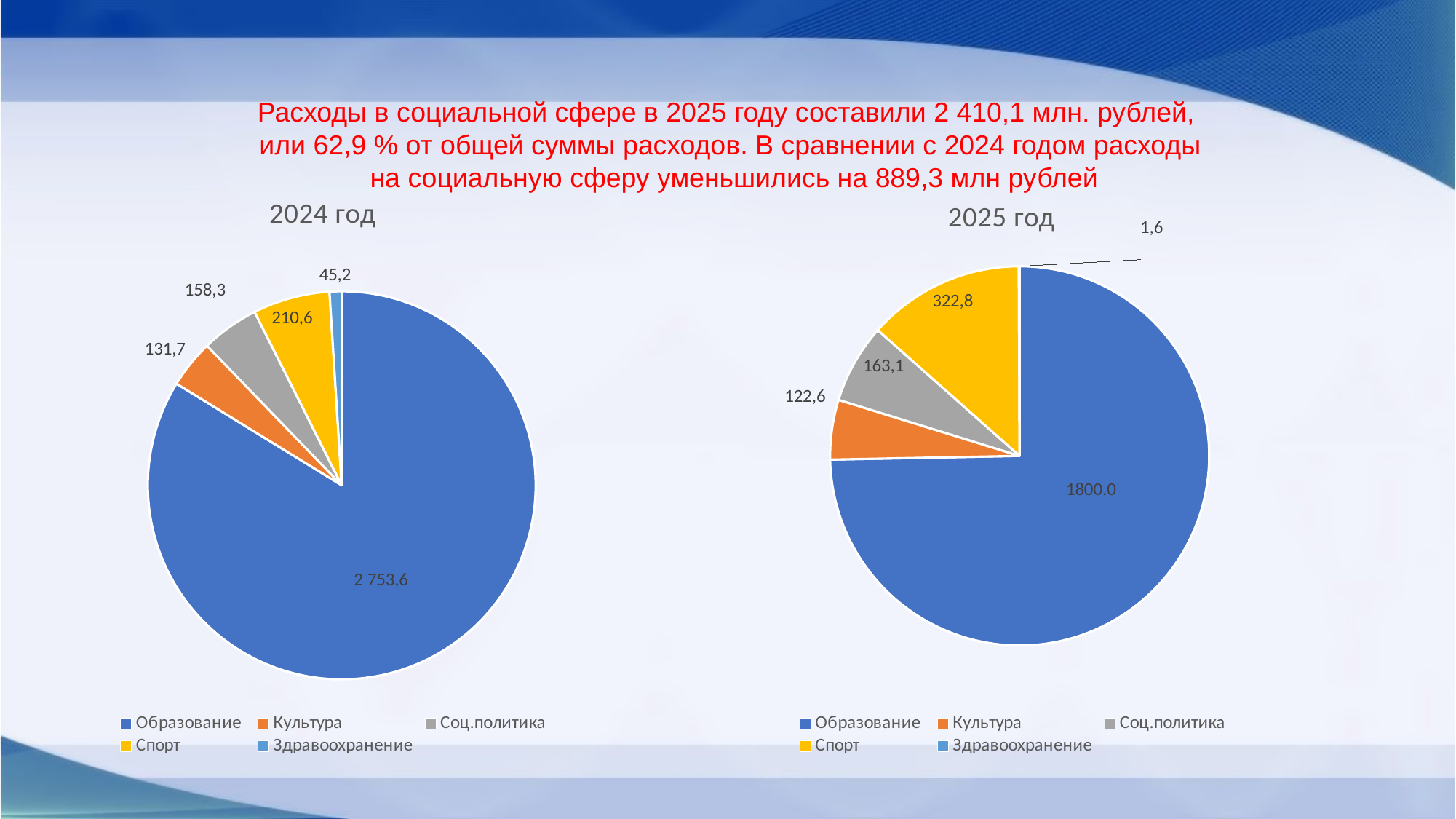
What type of chart is used for 2024 год? Pie chart In the 2025 год pie chart, what share of the total does Образование represent? 74.7% In the 2024 год pie chart, what is the value for Образование? 2 753,6 In the 2025 год pie chart, what is the value for Спорт? 322,8 In the 2025 год pie chart, which category has the smallest value? Здравоохранение In the 2024 год pie chart, which category has the largest value? Образование In the 2024 год pie chart, which colour represents Спорт? Yellow In the 2024 год pie chart, which is larger: Соц.политика or Культура? Соц.политика How many categories does the 2025 год pie chart show? 5 In the 2025 год pie chart, what is the value for Культура? 122,6 In the 2024 год pie chart, what is the value for Здравоохранение? 45,2 What is the difference between the Спорт value in the 2025 год chart and the Спорт value in the 2024 год chart? 112,2